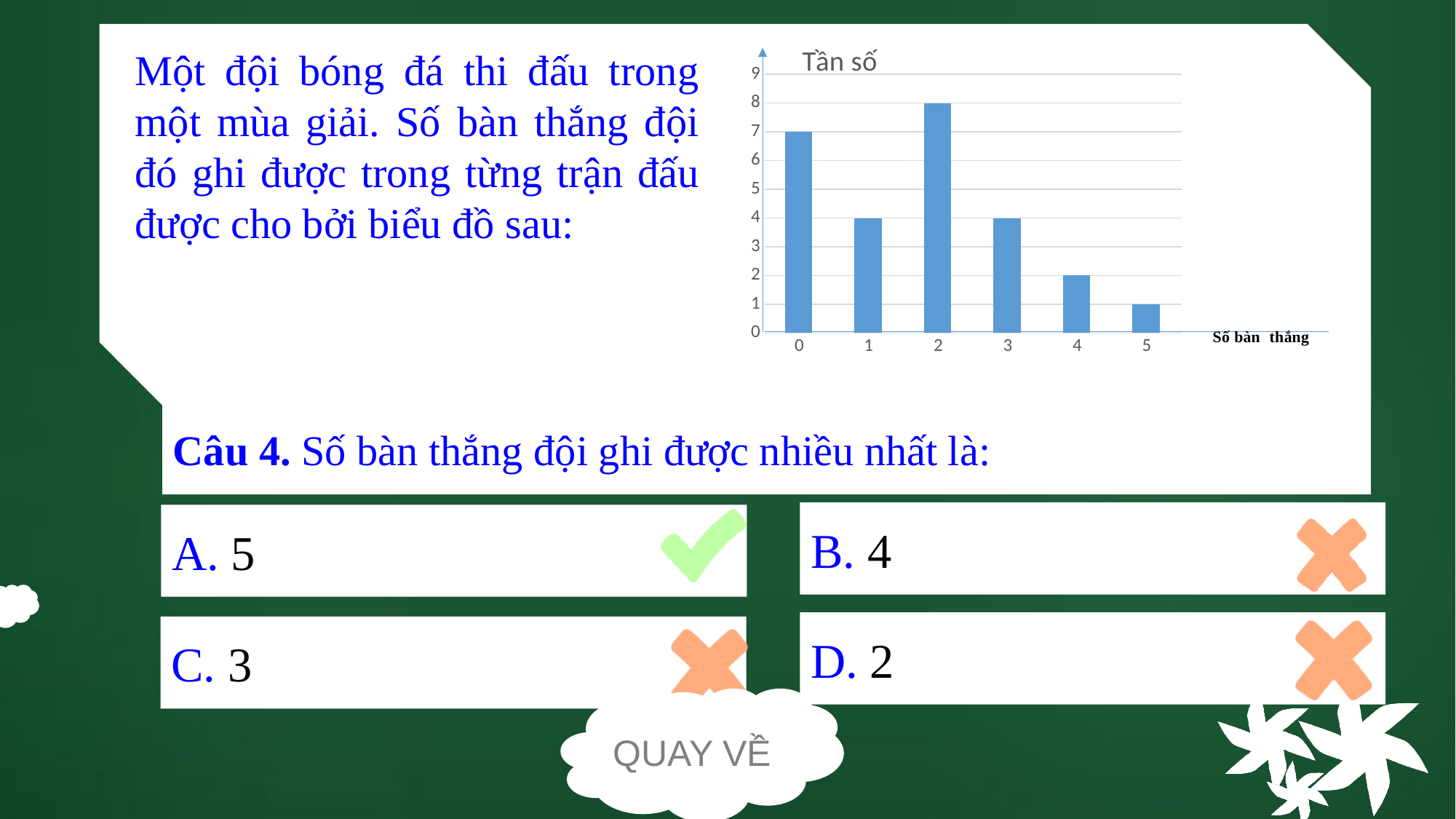
What kind of chart is shown on the slide? bar chart What is the frequency (Tần số) for 4 goals (Số bàn thắng = 4)? 2 What is the frequency (Tần số) for 2 goals (Số bàn thắng = 2)? 8 What is the difference between the frequency for 2 goals and the frequency for 0 goals? 1 Which has a larger frequency: 1 goal or 4 goals? 1 goal Is the frequency for 3 goals greater or less than 5? less What is the frequency (Tần số) for 5 goals (Số bàn thắng = 5)? 1 Which number of goals (Số bàn thắng) has the lowest frequency? 5 How many categories are shown on the x axis of the chart? 6 What is the label of the vertical axis of the chart? Tần số Which number of goals (Số bàn thắng) has the highest frequency? 2 What is the frequency (Tần số) for 0 goals (Số bàn thắng = 0)? 7